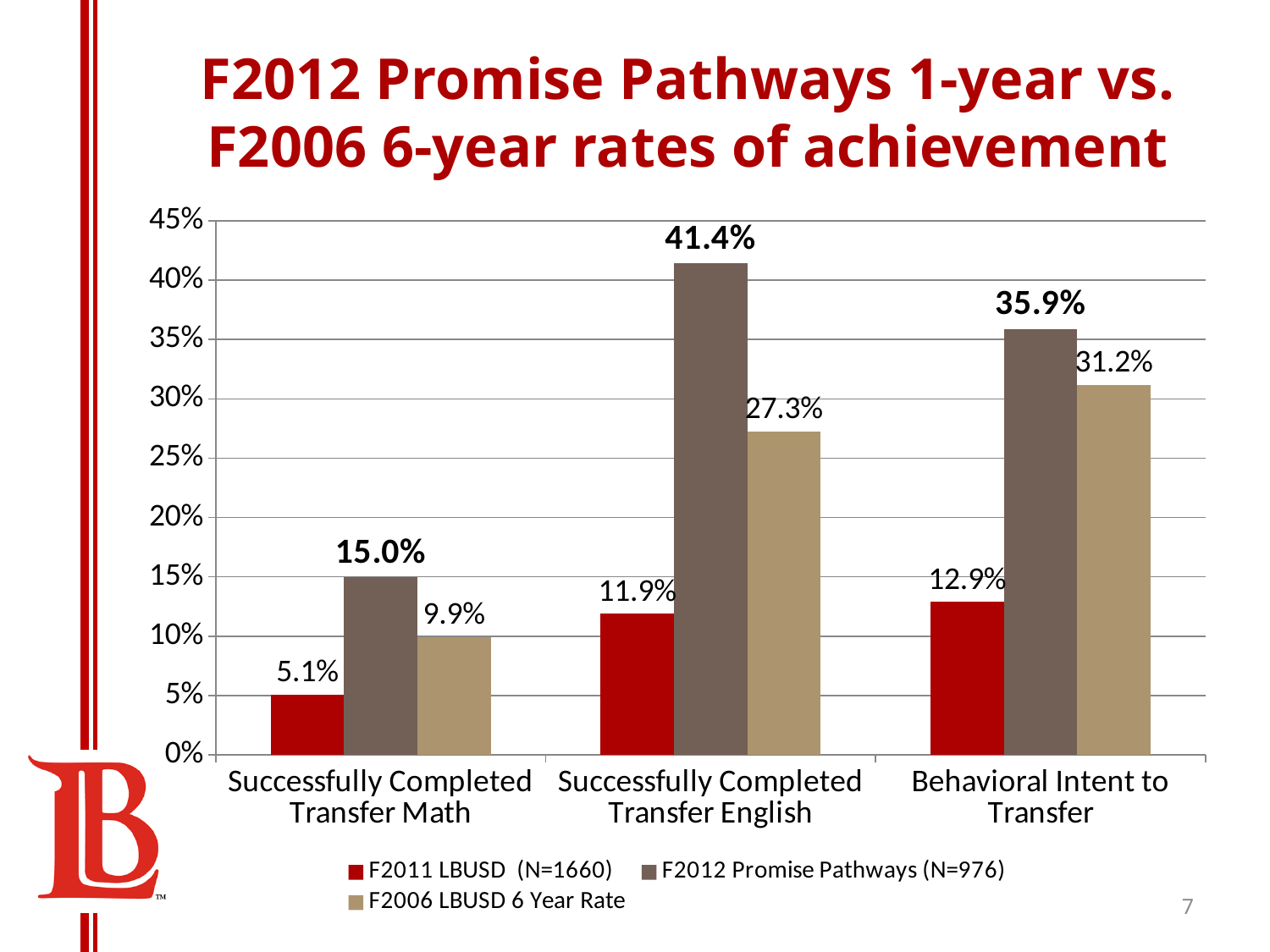
What is the difference between the F2012 Promise Pathways (N=976) and F2006 LBUSD 6 Year Rate values for Successfully Completed Transfer English? 14.1% Which category has the lowest F2011 LBUSD (N=1660) value? Successfully Completed Transfer Math How many series does the legend list? 3 What is the F2011 LBUSD (N=1660) value for Successfully Completed Transfer Math? 5.1% Which category has the highest F2012 Promise Pathways (N=976) value? Successfully Completed Transfer English What kind of chart is shown on the slide? bar chart For Behavioral Intent to Transfer, which is larger: the F2012 Promise Pathways (N=976) value or the F2006 LBUSD 6 Year Rate value? F2012 Promise Pathways (N=976) Is the F2011 LBUSD (N=1660) value for Successfully Completed Transfer English greater or less than 15%? less How many categories are shown on the x axis? 3 What is the F2006 LBUSD 6 Year Rate for Behavioral Intent to Transfer? 31.2% What is the F2012 Promise Pathways (N=976) value for Successfully Completed Transfer English? 41.4% What is the title of the slide? F2012 Promise Pathways 1-year vs. F2006 6-year rates of achievement